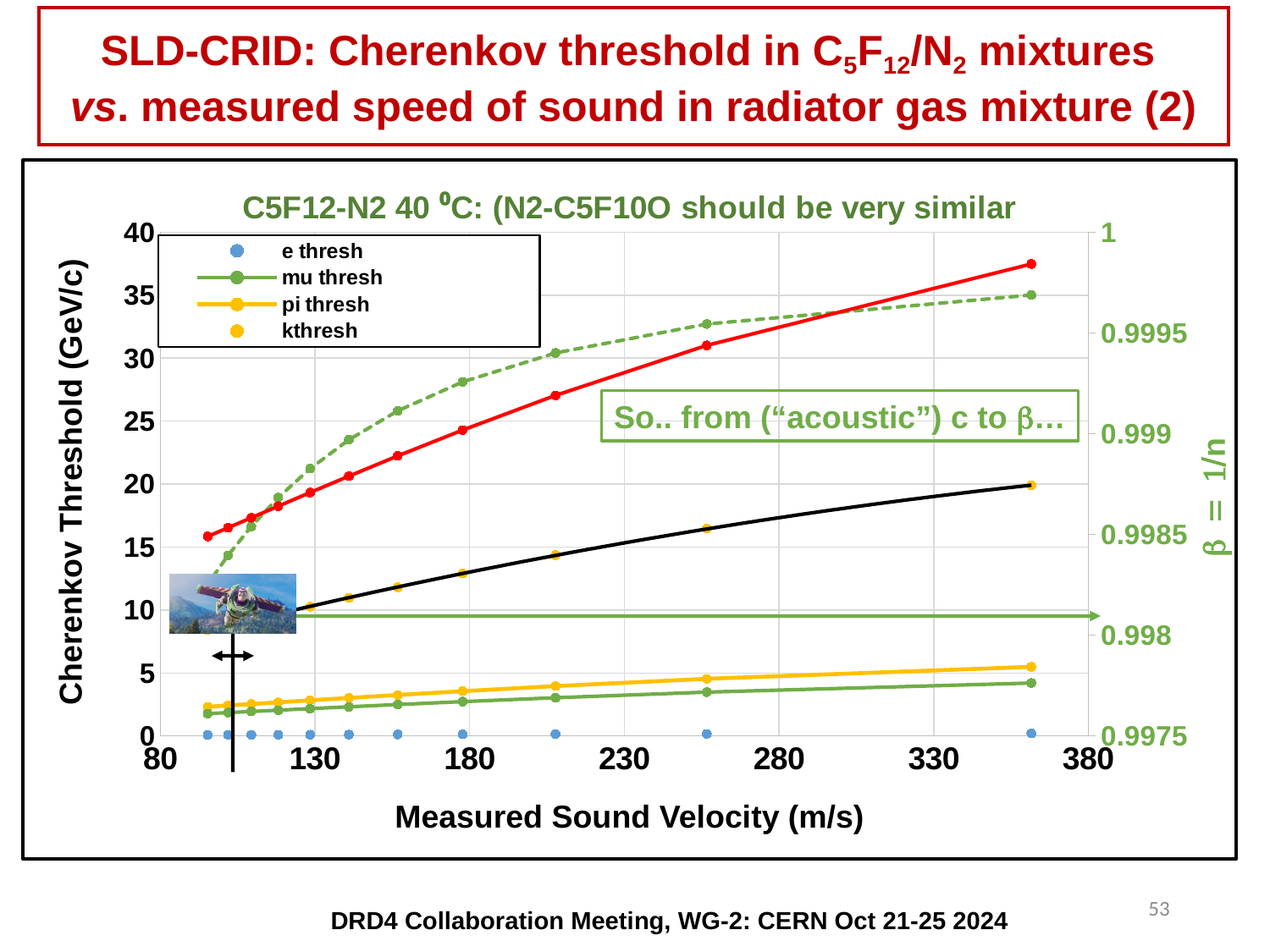
At a sound velocity of about 360 m/s, which is higher: the red line or the black line? the red line At a sound velocity of about 360 m/s, which is higher: the pi thresh series or the mu thresh series? pi thresh What is the label of the x axis of the chart? Measured Sound Velocity (m/s) Does the mu thresh series rise or fall as the measured sound velocity increases? rise What kind of chart is shown on the slide? line chart What is the label of the left y axis of the chart? Cherenkov Threshold (GeV/c) Which legend series has the lowest values across the whole chart? e thresh Is the value of the red line at a sound velocity of about 100 m/s greater or less than 20 GeV/c? less Does the red line rise or fall as the measured sound velocity increases? rise Is the value of the red line at a sound velocity of about 360 m/s greater or less than 35 GeV/c? greater Is the value of the mu thresh series at a sound velocity of about 360 m/s greater or less than 5 GeV/c? less How many series does the chart's legend list? 4